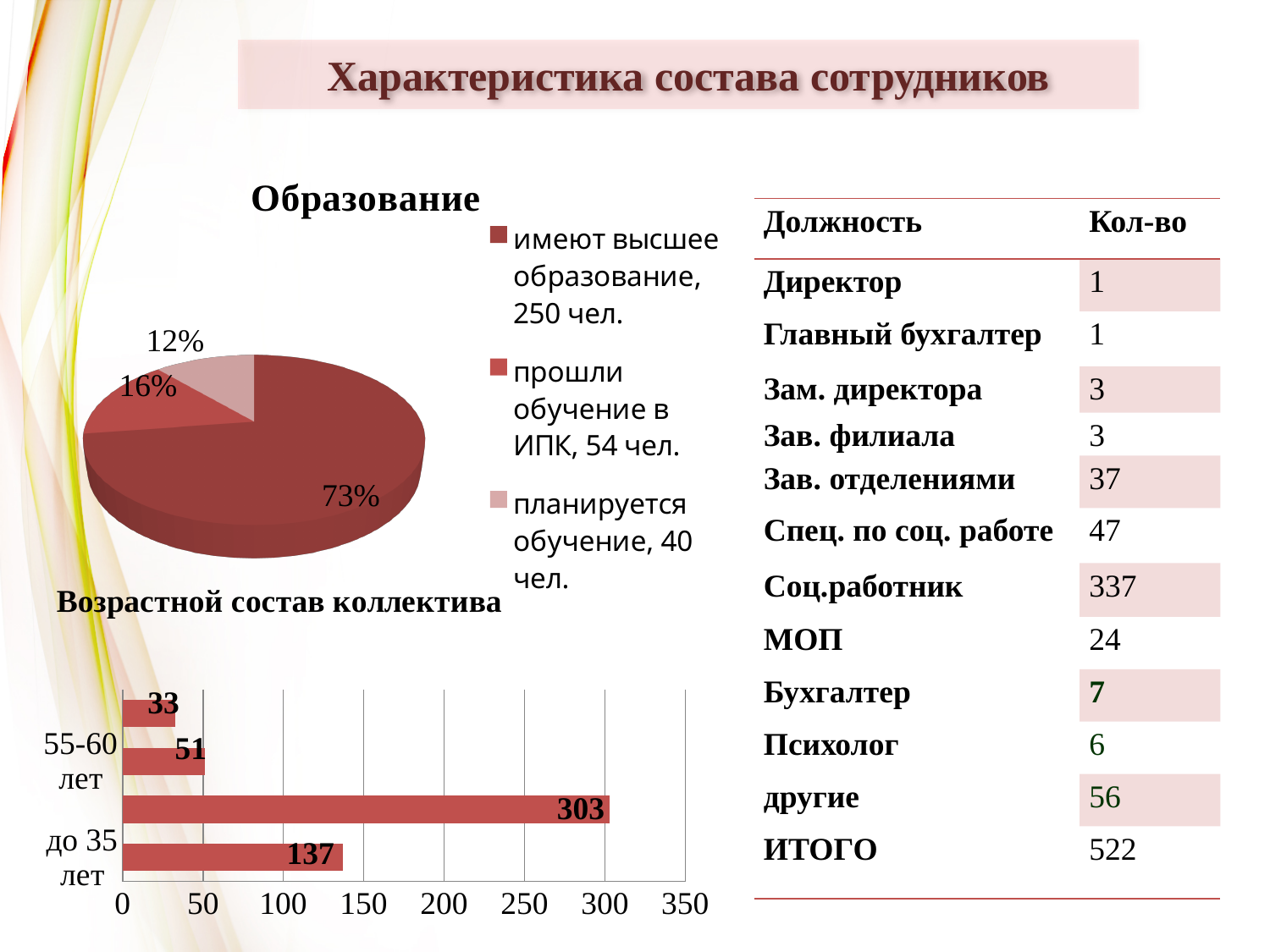
In the pie chart 'Образование', what is the difference in percentage points between the 73% slice and the 16% slice? 57% In the pie chart 'Образование', what percentage is shown for the slice 'планируется обучение, 40 чел.'? 12% In the bar chart 'Возрастной состав коллектива', what is the value for 'до 35 лет'? 137 In the pie chart 'Образование', which legend category has the largest slice? имеют высшее образование, 250 чел. In the bar chart 'Возрастной состав коллектива', what is the value for '55-60 лет'? 51 What kind of chart is 'Возрастной состав коллектива'? bar chart In the bar chart 'Возрастной состав коллектива', what is the highest value shown on any bar? 303 In the bar chart 'Возрастной состав коллектива', what is the lowest value shown on any bar? 33 How many bars are plotted in the bar chart 'Возрастной состав коллектива'? 4 In the pie chart 'Образование', which legend category has the smallest slice? планируется обучение, 40 чел. How many entries does the legend of the pie chart 'Образование' list? 3 In the pie chart 'Образование', what percentage is shown for the slice 'имеют высшее образование, 250 чел.'? 73%